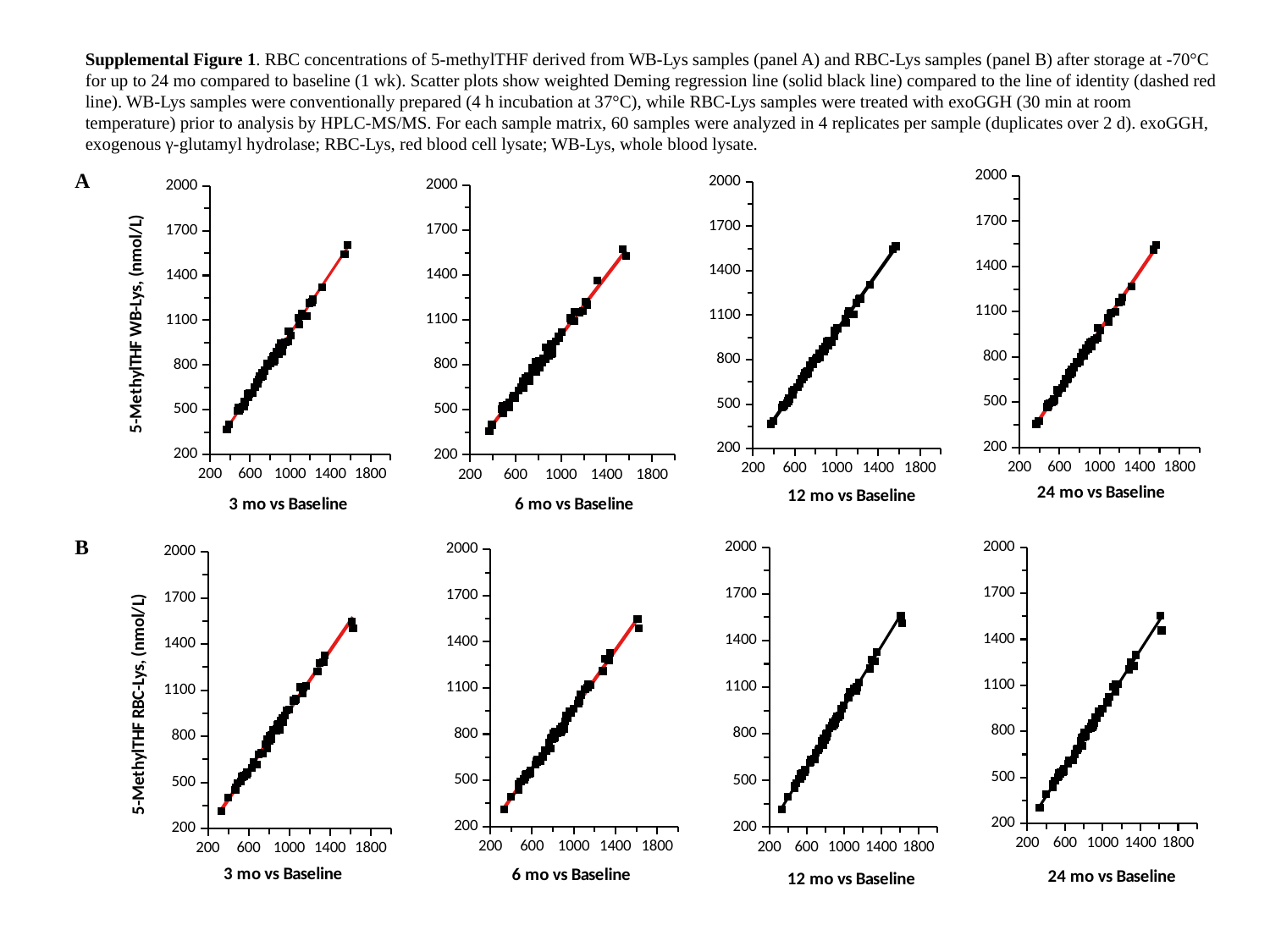
In the panel B '24 mo vs Baseline' chart, do the plotted values rise or fall as the x-axis value increases? Rise In the panel A '3 mo vs Baseline' chart, do the plotted values rise or fall as the x-axis value increases? Rise What is the y-axis label of the charts in panel A? 5-MethylTHF WB-Lys, (nmol/L) In the panel A '12 mo vs Baseline' chart, is the lowest plotted y value greater or less than 500? less What is the y-axis label of the charts in panel B? 5-MethylTHF RBC-Lys, (nmol/L) How many charts are in panel A? 4 In the panel A '3 mo vs Baseline' chart, is the highest plotted y value greater or less than 1400? greater In the panel B '6 mo vs Baseline' chart, is the highest plotted y value greater or less than 1400? greater How many charts are shown on the slide in total? 8 What kind of charts are shown on the slide? Scatter plots